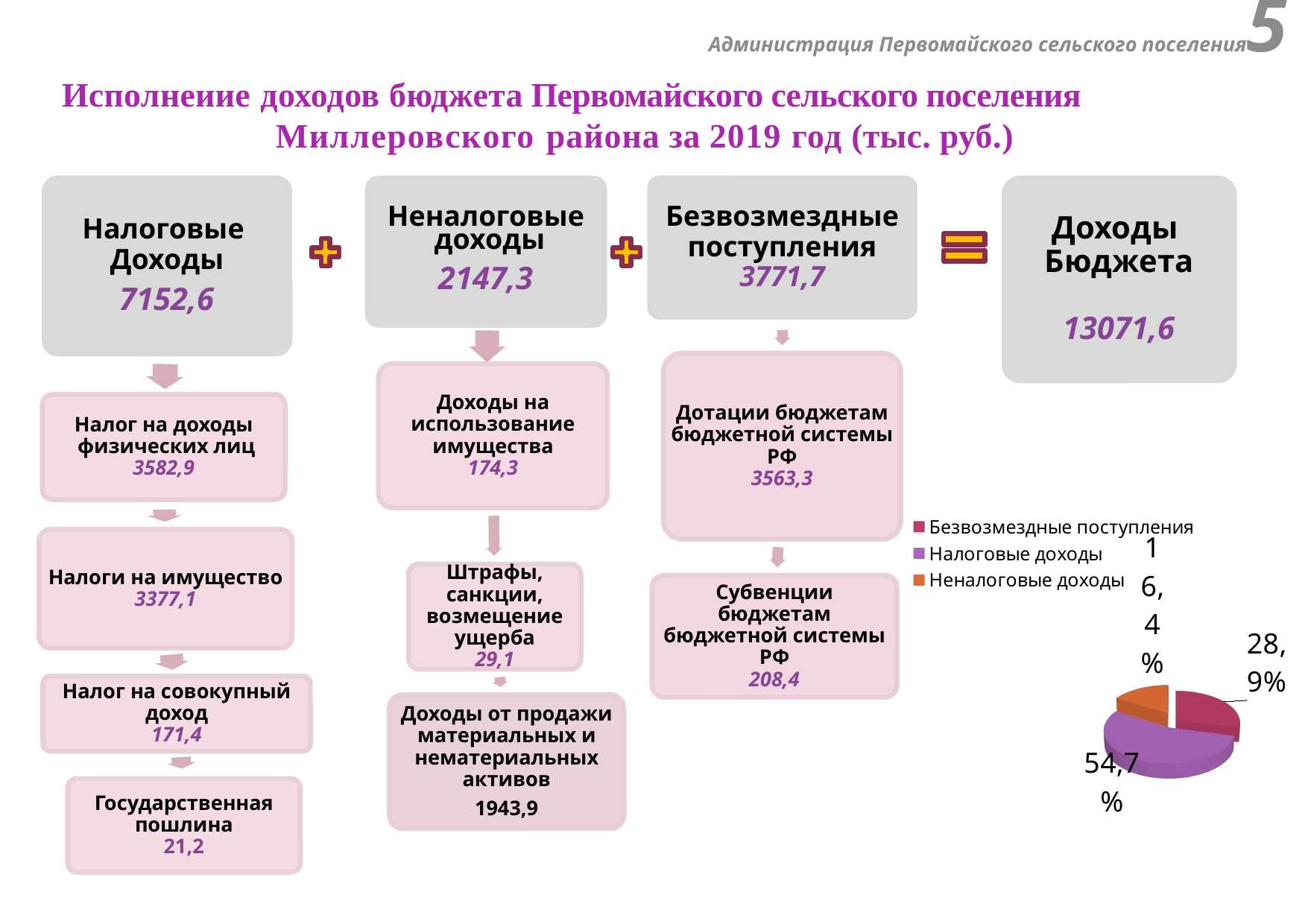
What kind of chart is shown on the slide? pie chart In the pie chart, by how many percentage points does Безвозмездные поступления exceed Неналоговые доходы? 12,5 Which category has the smallest slice in the pie chart? Неналоговые доходы What share of the pie chart does Безвозмездные поступления have? 28,9% In the pie chart, which is larger: Безвозмездные поступления or Неналоговые доходы? Безвозмездные поступления In the pie chart, by how many percentage points does Налоговые доходы exceed Безвозмездные поступления? 25,8 What share of the pie chart does Налоговые доходы have? 54,7% What share of the pie chart does Неналоговые доходы have? 16,4% Which legend entry in the pie chart is shown in orange? Неналоговые доходы Which category has the largest slice in the pie chart? Налоговые доходы What colour is the Налоговые доходы slice in the pie chart? purple How many categories does the pie chart's legend list? 3